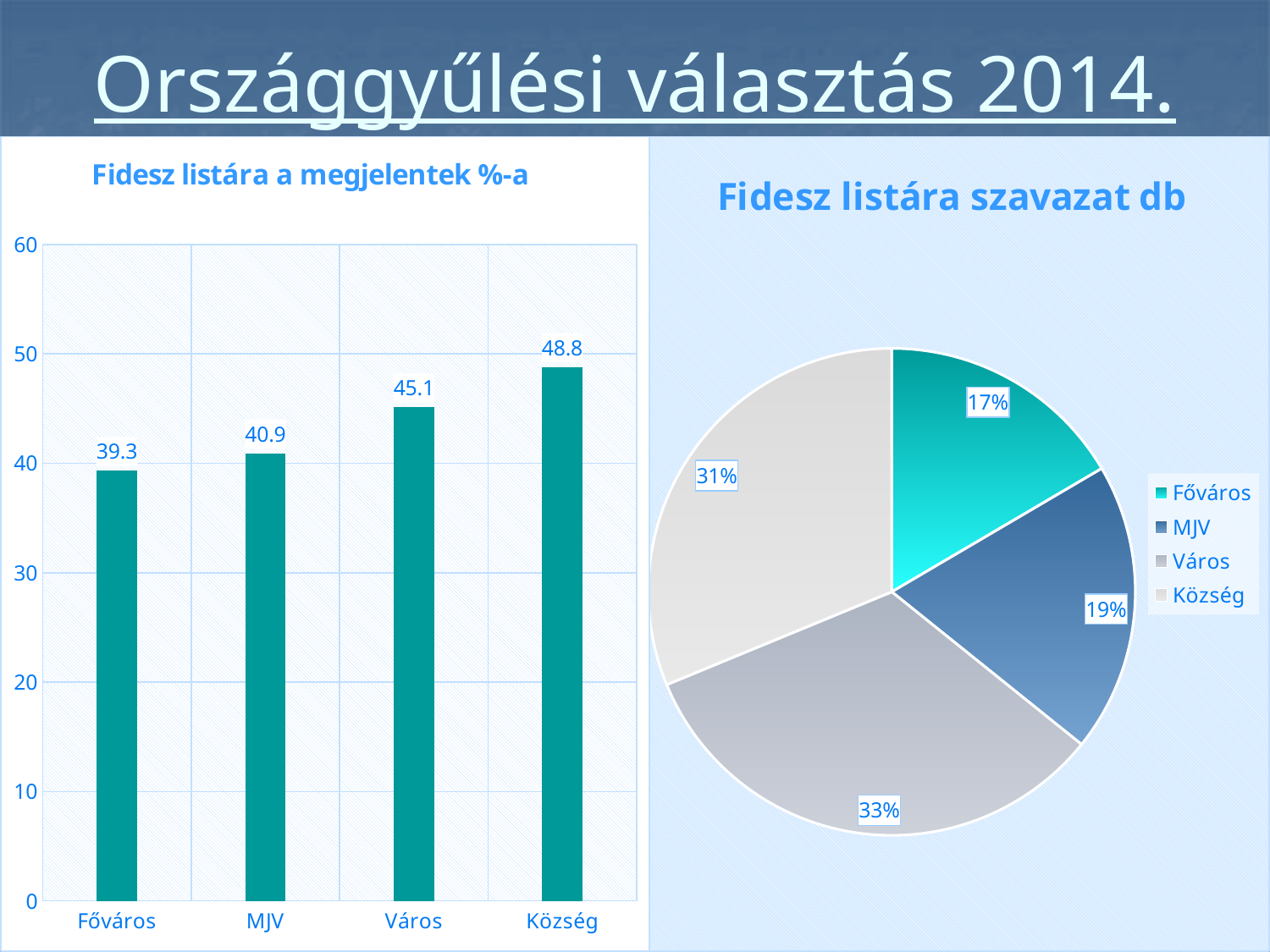
In the bar chart 'Fidesz listára a megjelentek %-a', what is the value for Város? 45.1 In the bar chart 'Fidesz listára a megjelentek %-a', what is the value for Főváros? 39.3 In the bar chart 'Fidesz listára a megjelentek %-a', do the values rise or fall from Főváros to Község? rise In the bar chart 'Fidesz listára a megjelentek %-a', which category has the highest value? Község In the bar chart 'Fidesz listára a megjelentek %-a', which category has the lowest value? Főváros In the bar chart 'Fidesz listára a megjelentek %-a', what is the difference between the values for Község and MJV? 7.9 In the pie chart 'Fidesz listára szavazat db', which is larger, the slice for MJV or the slice for Főváros? MJV In the bar chart 'Fidesz listára a megjelentek %-a', how many categories are shown? 4 In the pie chart 'Fidesz listára szavazat db', what share does Község have? 31% How many entries does the legend of the pie chart 'Fidesz listára szavazat db' list? 4 In the pie chart 'Fidesz listára szavazat db', which category has the largest slice? Város What kind of chart is 'Fidesz listára a megjelentek %-a'? bar chart